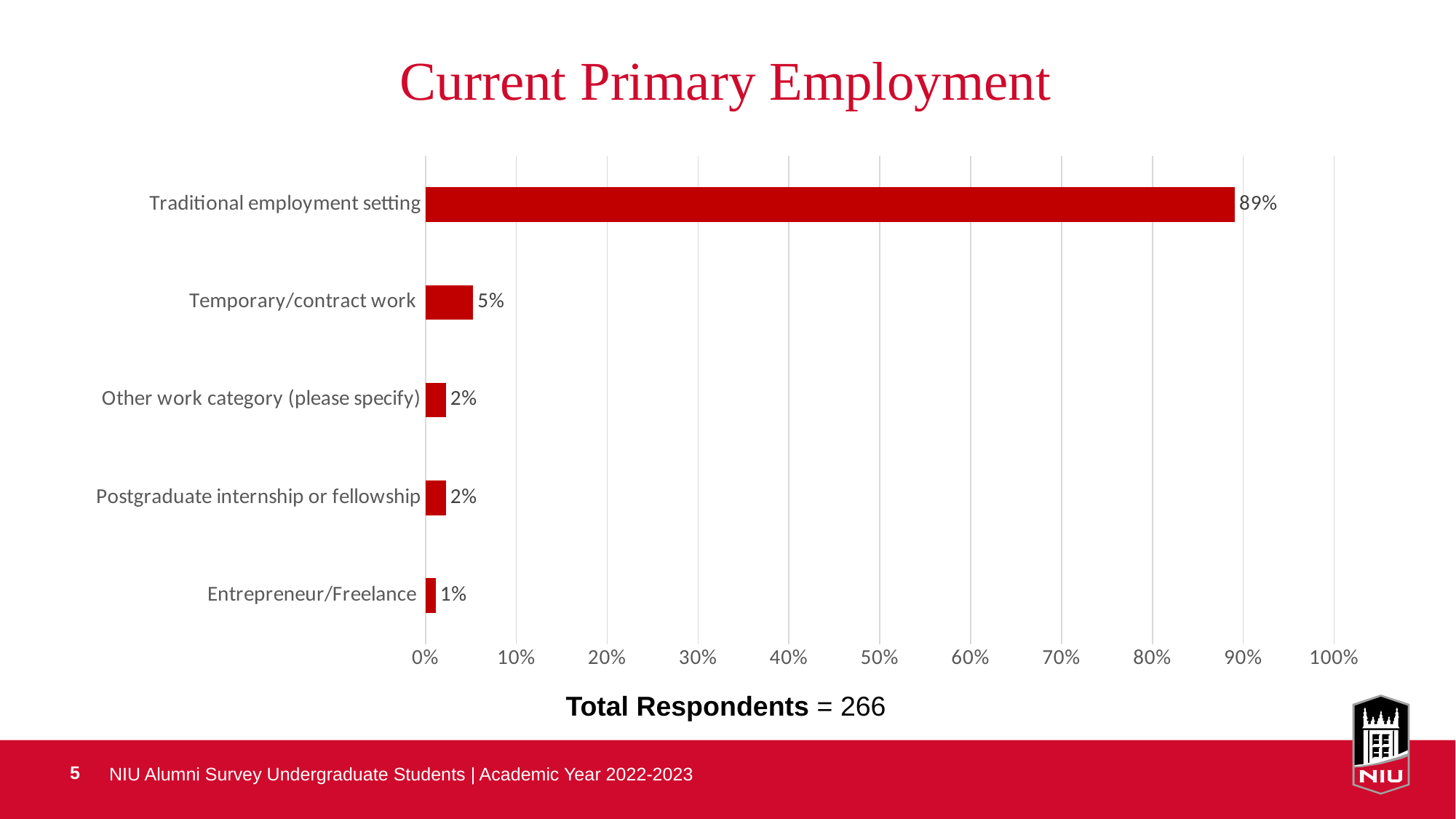
Is the value for Traditional employment setting greater or less than 80%? greater What is the value for Temporary/contract work? 5% Which category has the lowest value? Entrepreneur/Freelance What is the value for Postgraduate internship or fellowship? 2% What percentage of respondents are in a traditional employment setting? 89% What is the total number of respondents stated below the chart? 266 Which category has the highest value? Traditional employment setting What kind of chart is shown on the slide? Bar chart What is the difference between Traditional employment setting and Temporary/contract work? 84% Which is larger, Temporary/contract work or Other work category (please specify)? Temporary/contract work How many categories are shown in the chart? 5 What is the value for Entrepreneur/Freelance? 1%